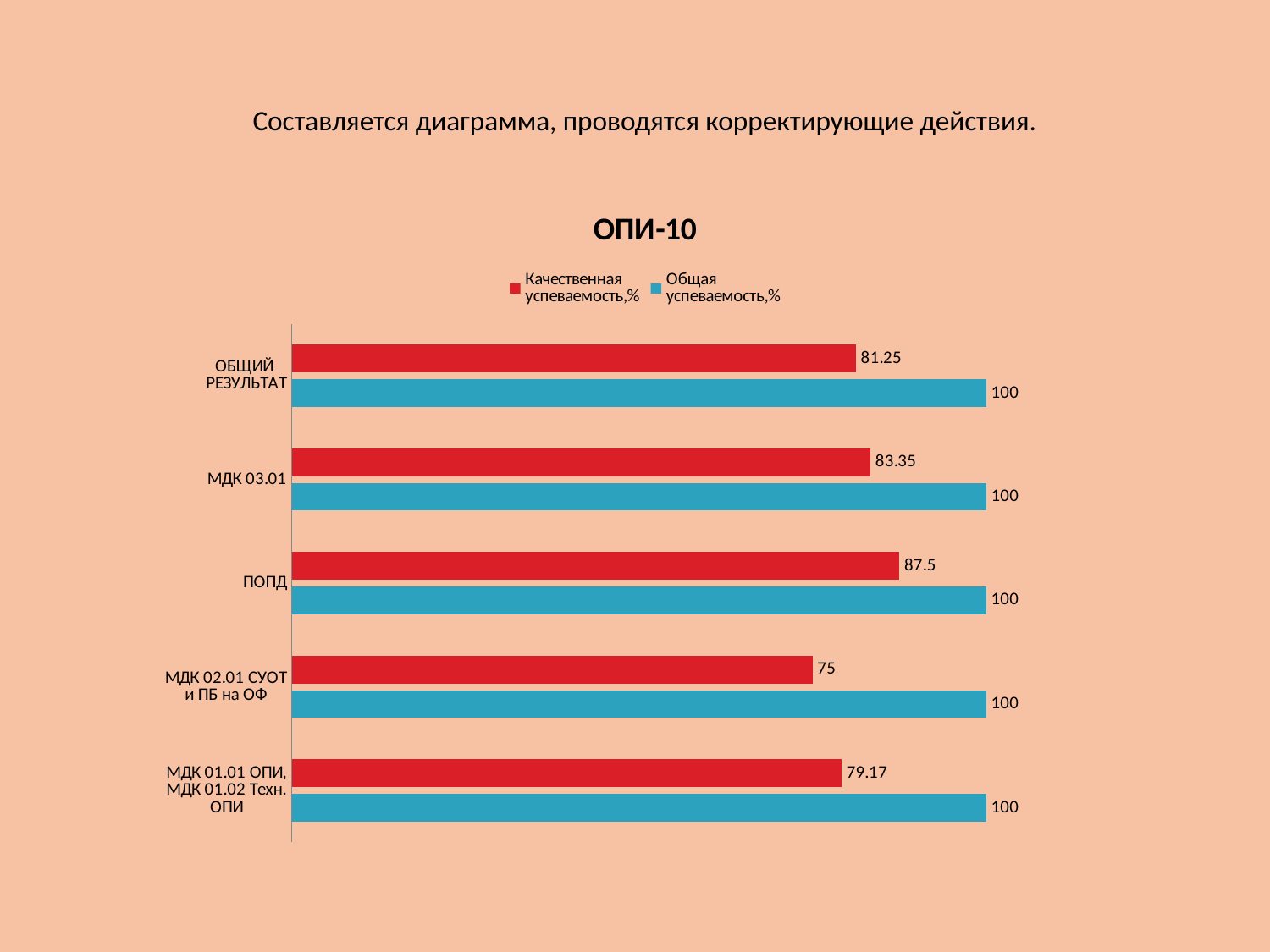
What is the title of the chart? ОПИ-10 What is the value of Качественная успеваемость,% for ОБЩИЙ РЕЗУЛЬТАТ? 81.25 What type of chart is shown on the slide? bar chart How many categories are shown on the chart? 5 Which category has the highest value of Качественная успеваемость,%? ПОПД Which is larger: Качественная успеваемость,% for ПОПД or for МДК 03.01? ПОПД What is the value of Общая успеваемость,% for МДК 02.01 СУОТ и ПБ на ОФ? 100 What is the difference between Общая успеваемость,% and Качественная успеваемость,% for МДК 01.01 ОПИ, МДК 01.02 Техн. ОПИ? 20.83 What is the value of Качественная успеваемость,% for МДК 03.01? 83.35 What is the value of Качественная успеваемость,% for ПОПД? 87.5 How many series does the legend list? 2 Which category has the lowest value of Качественная успеваемость,%? МДК 02.01 СУОТ и ПБ на ОФ